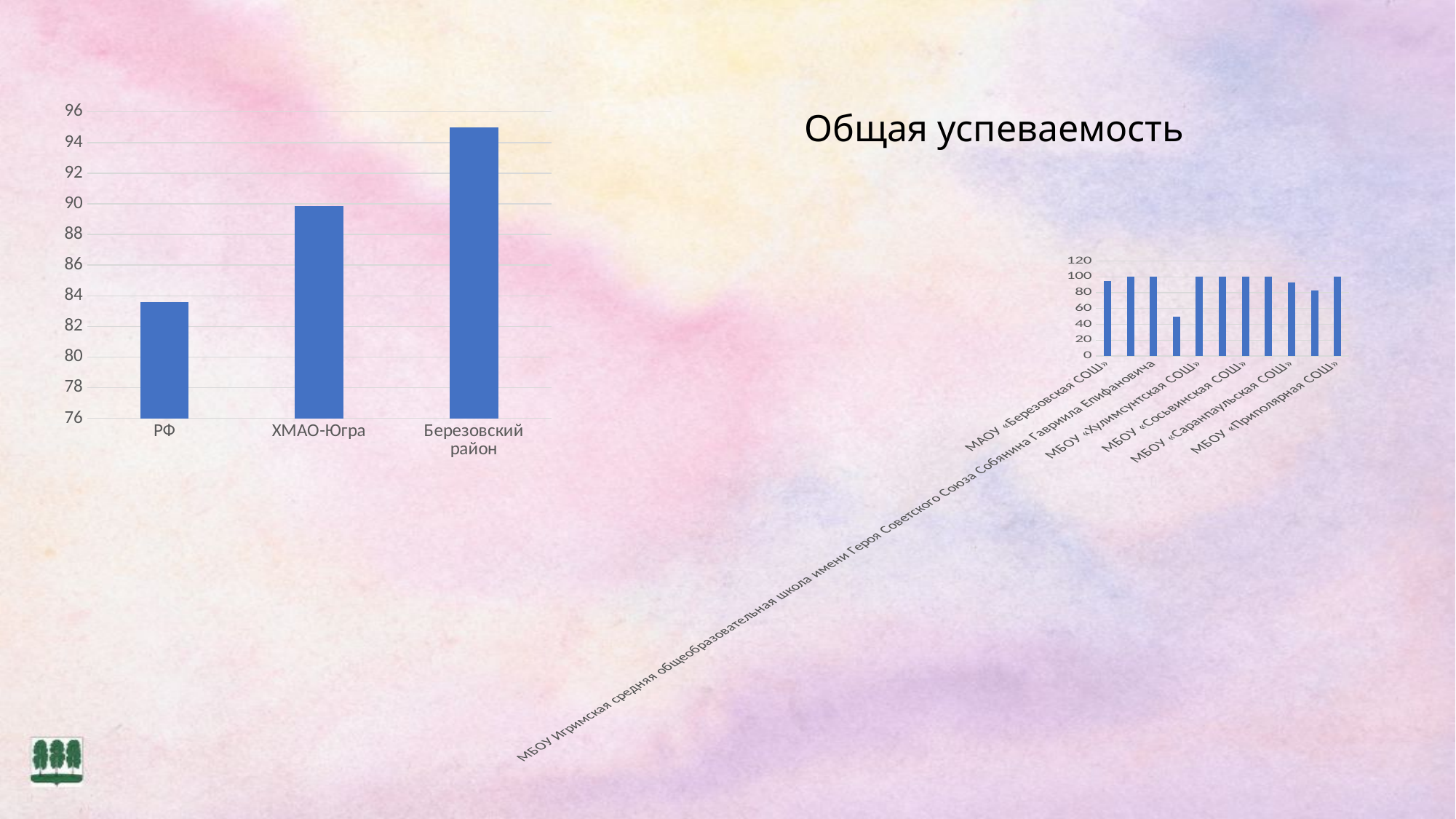
In the chart on the left of the slide, which category has the highest value? Березовский район What kind of chart is the chart on the right of the slide? bar chart In the chart on the left of the slide, is the value for Березовский район greater or less than 94? greater In the chart on the left of the slide, do the values rise or fall from left to right along the x axis? rise What is the title shown above the chart on the right of the slide? Общая успеваемость In the chart on the left of the slide, is the value for ХМАО-Югра greater or less than 88? greater In the chart on the left of the slide, which category has the lowest value? РФ What is the highest value shown on the vertical axis of the chart on the right of the slide? 120 In the chart on the left of the slide, which is larger, the value for РФ or the value for ХМАО-Югра? ХМАО-Югра What kind of chart is the chart on the left of the slide? bar chart How many categories are shown in the chart on the left of the slide? 3 In the chart on the left of the slide, is the value for РФ greater or less than 82? greater